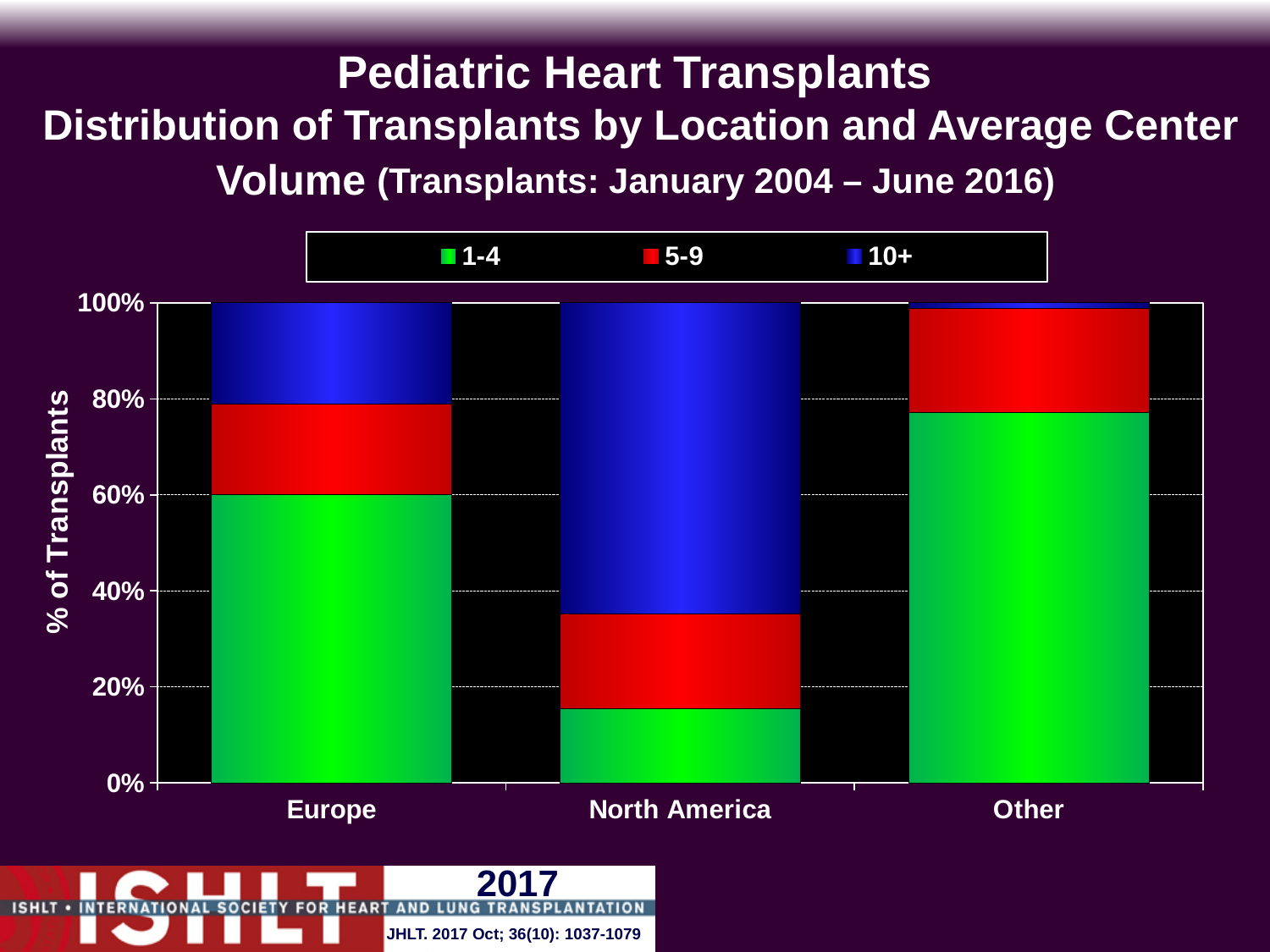
Which location has the largest share of transplants in the 10+ center volume category? North America Which location has the largest share of transplants in the 1-4 center volume category? Other Which has a larger 1-4 share, Europe or North America? Europe Is the 1-4 share for Other greater or less than 60%? greater What kind of chart is shown on the slide? Stacked bar chart How many locations are shown on the x axis of the chart? 3 Is the 1-4 share for North America greater or less than 20%? less Which location has the smallest share of transplants in the 1-4 center volume category? North America Which location has the smallest share of transplants in the 10+ center volume category? Other How many series does the chart's legend list? 3 What is the label on the y axis of the chart? % of Transplants What are the three center volume categories listed in the legend? 1-4, 5-9, 10+